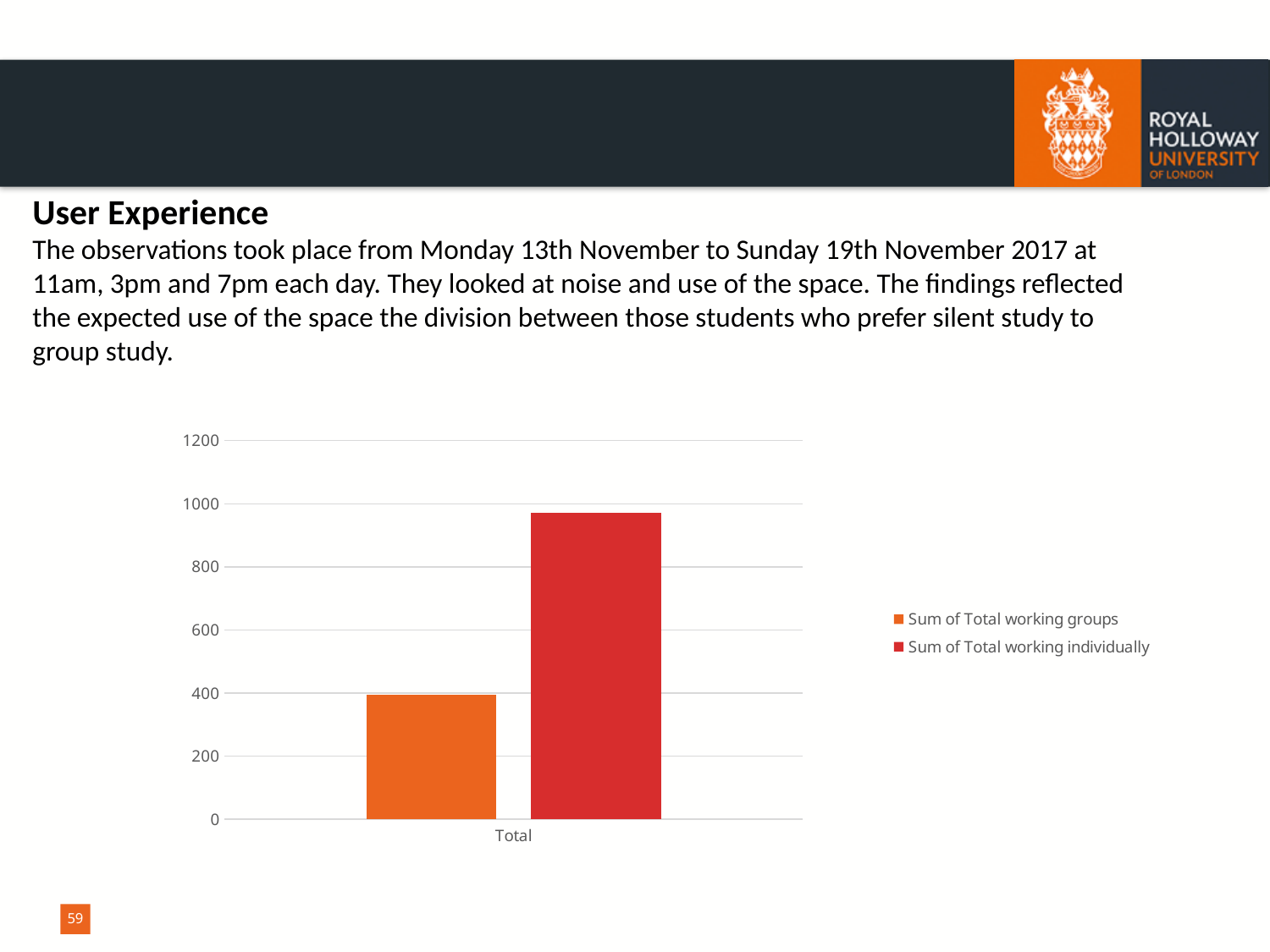
Is the value for Sum of Total working groups greater or less than 600? less What kind of chart is shown on the slide? bar chart How many categories are shown on the x axis of the chart? 1 Is the value for Sum of Total working groups greater or less than 200? greater How many series does the chart legend list? 2 Is the value for Sum of Total working individually greater or less than 1200? less Which series has the taller bar, Sum of Total working groups or Sum of Total working individually? Sum of Total working individually Which series has the lowest value in the chart? Sum of Total working groups Which series has the highest value in the chart? Sum of Total working individually What is the category label on the x axis of the chart? Total What colour is the bar for Sum of Total working groups? orange